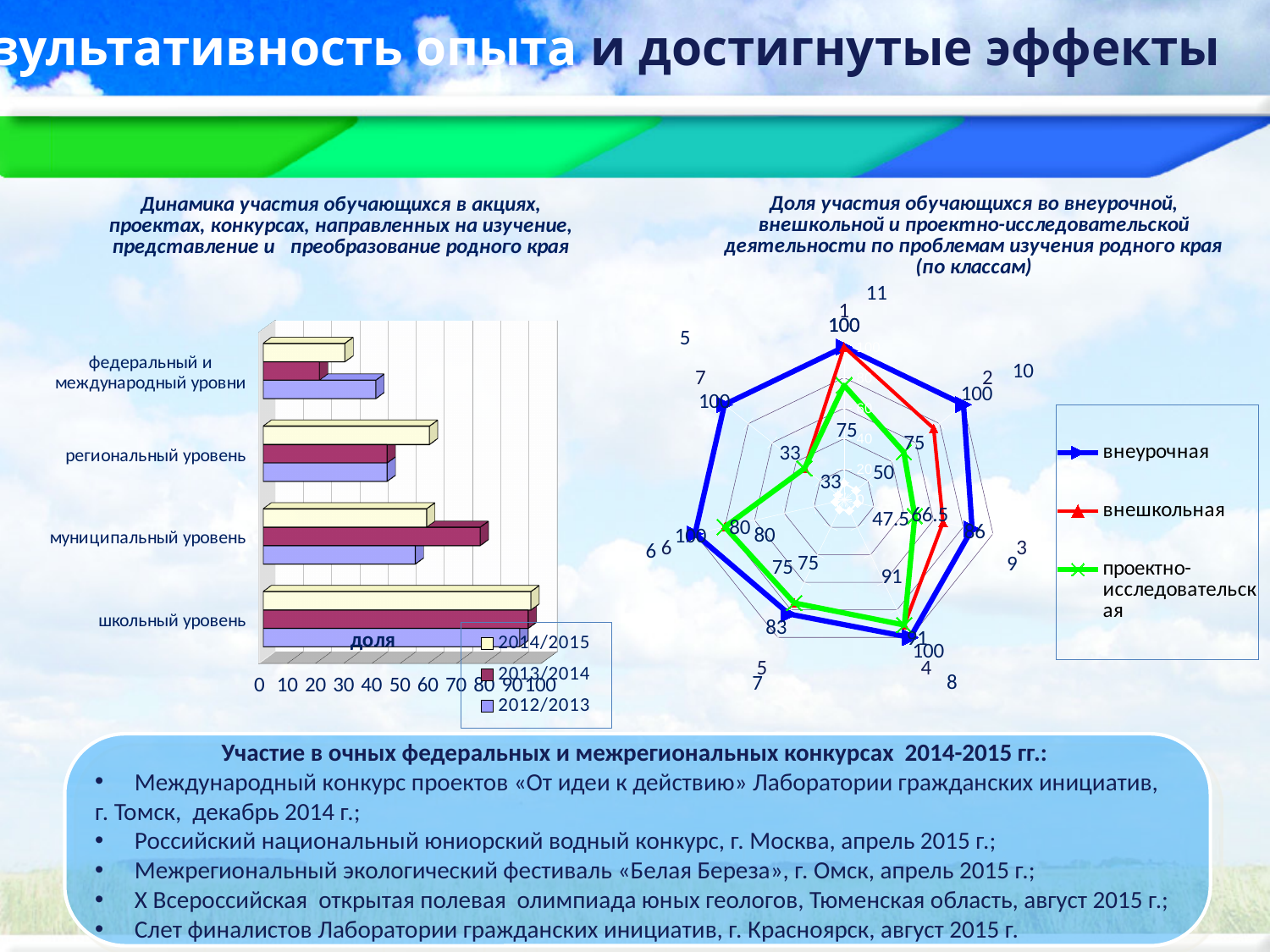
In the left bar chart, is the 2013/2014 value for «федеральный и международный уровни» greater or less than 30? less In the left bar chart, which category has the lowest value for the 2013/2014 series? федеральный и международный уровни In the left bar chart, how many series does the legend list? 3 In the left bar chart, how many categories (levels) are shown on the vertical axis? 4 What kind of chart is the right chart titled «Доля участия обучающихся во внеурочной, внешкольной и проектно-исследовательской деятельности...»? radar chart In the left bar chart, for «федеральный и международный уровни», which is larger: the 2012/2013 value or the 2014/2015 value? 2012/2013 In the left bar chart, is the 2014/2015 value for «школьный уровень» greater or less than 90? greater In the left bar chart, which series has the highest value for «муниципальный уровень»? 2013/2014 In the left bar chart, which category has the highest value for the 2014/2015 series? школьный уровень What kind of chart is the left chart titled «Динамика участия обучающихся в акциях, проектах, конкурсах...»? bar chart In the right radar chart, what are the three series listed in the legend? внеурочная, внешкольная, проектно-исследовательская In the right radar chart, how many series does the legend list? 3